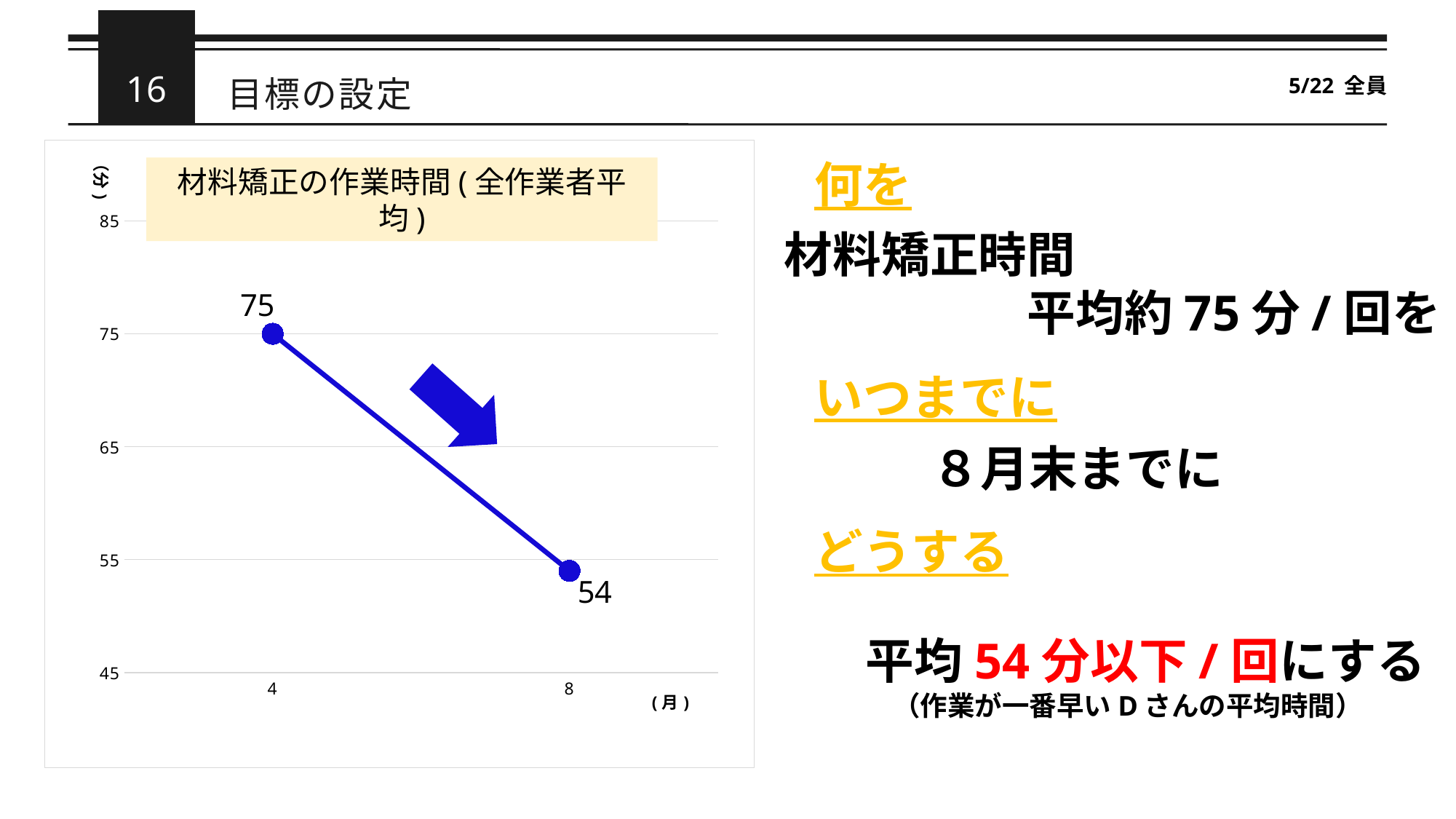
What is the difference between the value for month 4 and the value for month 8? 21 What kind of chart is shown on the slide? line chart Which month has the lowest value? 8 What is the value plotted for month 8? 54 Is the value for month 8 greater or less than 55? less What unit is shown on the x axis of the chart? 月 What is the value plotted for month 4? 75 Which month has the higher value, 4 or 8? 4 How many data points are plotted on the chart? 2 What is the title of the chart? 材料矯正の作業時間(全作業者平均) Do the values rise or fall from month 4 to month 8? fall Is the value for month 4 greater or less than 65? greater